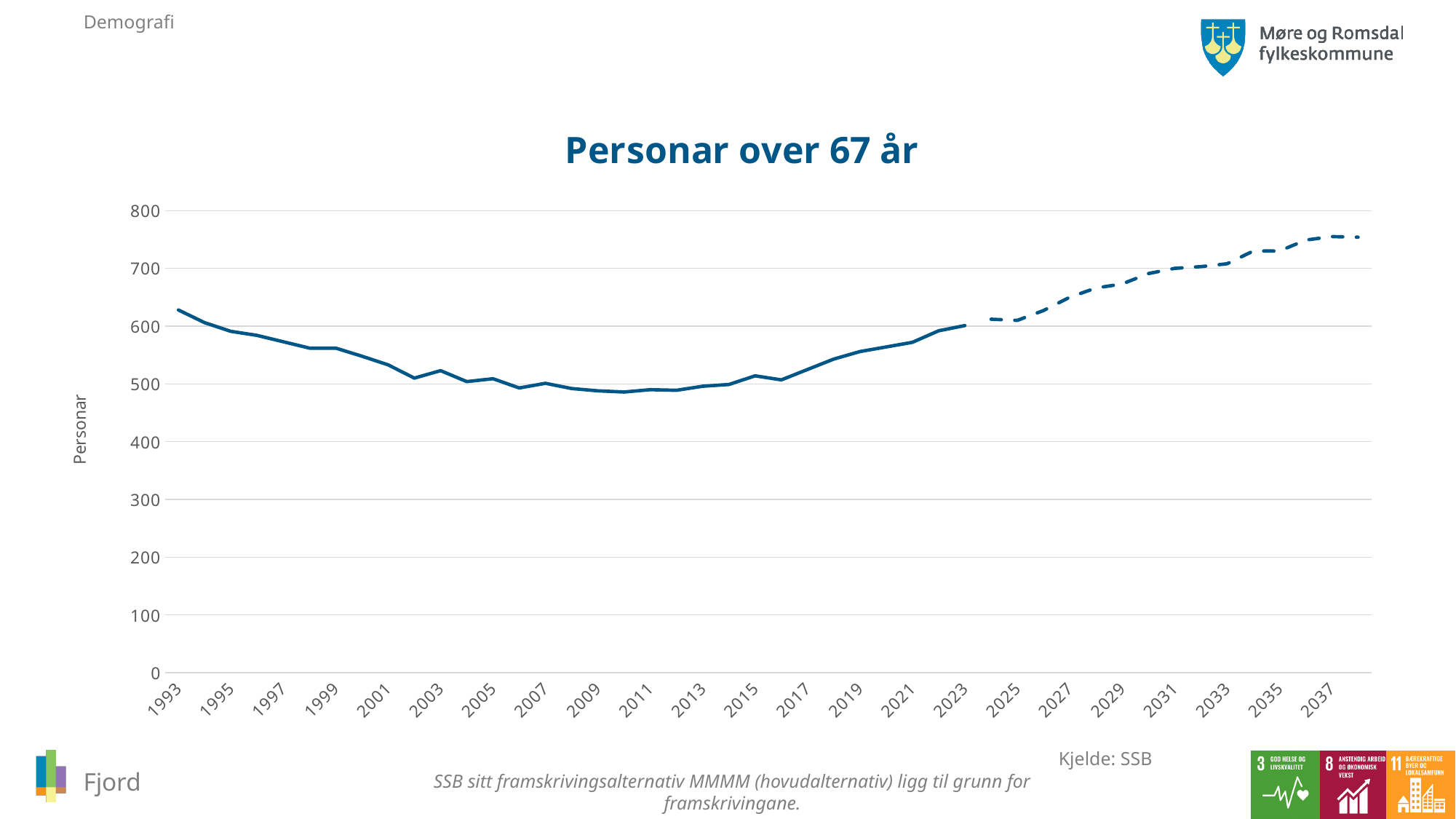
Is the value for 2021 greater or less than 600? less Is the value for 2010 greater or less than 500? less Do the values rise or fall from 2023 to 2037? rise Which year has the larger value, 1993 or 2037? 2037 Is the value for 2029 greater or less than 600? greater What kind of chart is shown on the slide? line chart What is the title of the chart? Personar over 67 år What is the label on the vertical axis of the chart? Personar Which year has the larger value, 1993 or 2010? 1993